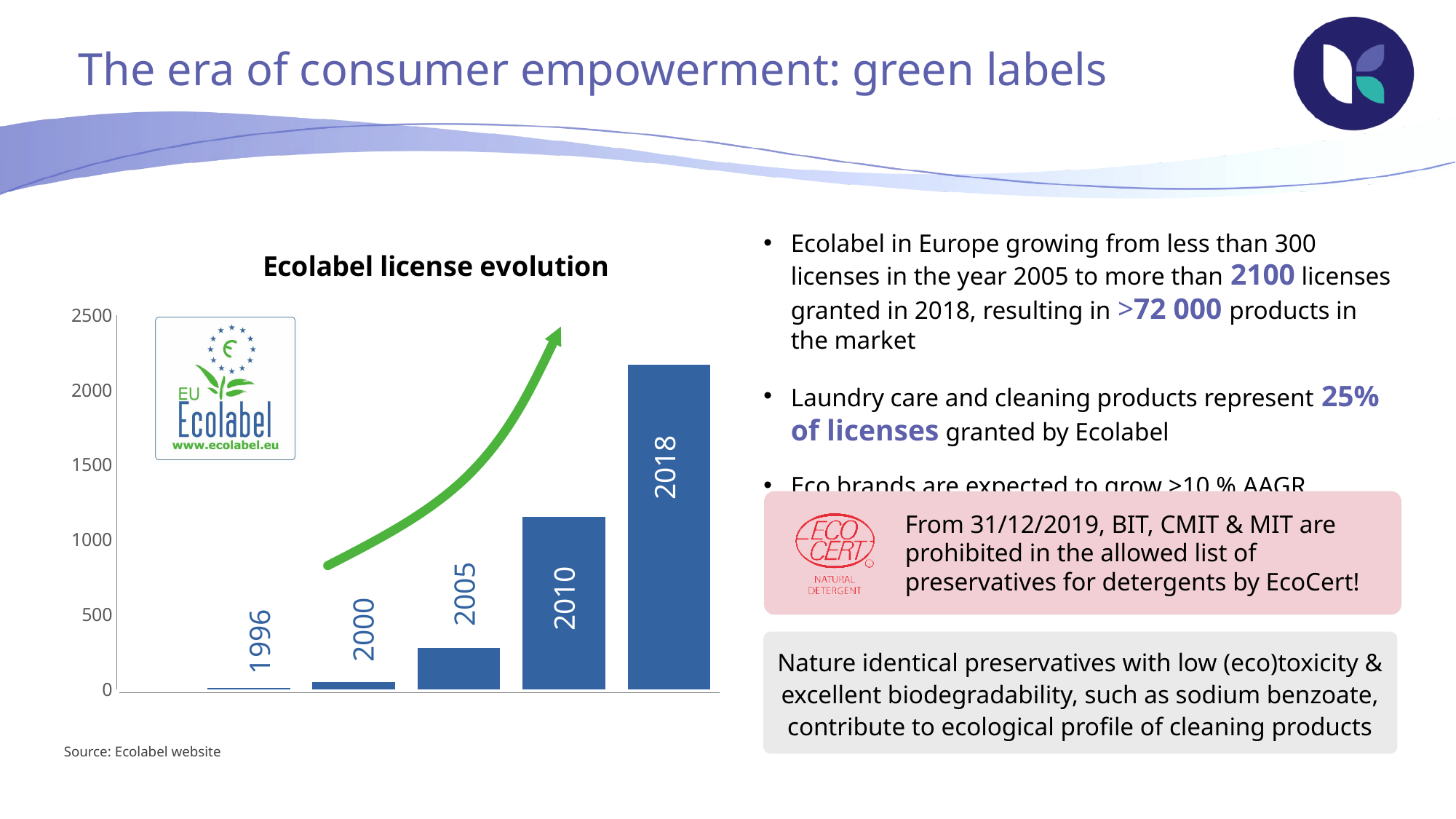
Is the value for 2018 greater or less than 2000? greater Is the value for 2010 greater or less than 1500? less Do the values in the Ecolabel license evolution chart rise or fall from 1996 to 2018? rise What is the title of the chart? Ecolabel license evolution What is the highest value shown on the vertical axis of the chart? 2500 Which year has the highest bar in the Ecolabel license evolution chart? 2018 What kind of chart is shown on the slide? bar chart Which year has the lowest bar in the Ecolabel license evolution chart? 1996 Is the value for 2010 greater or less than 1000? greater How many years are plotted in the Ecolabel license evolution chart? 5 Which year has the larger value, 2005 or 2010? 2010